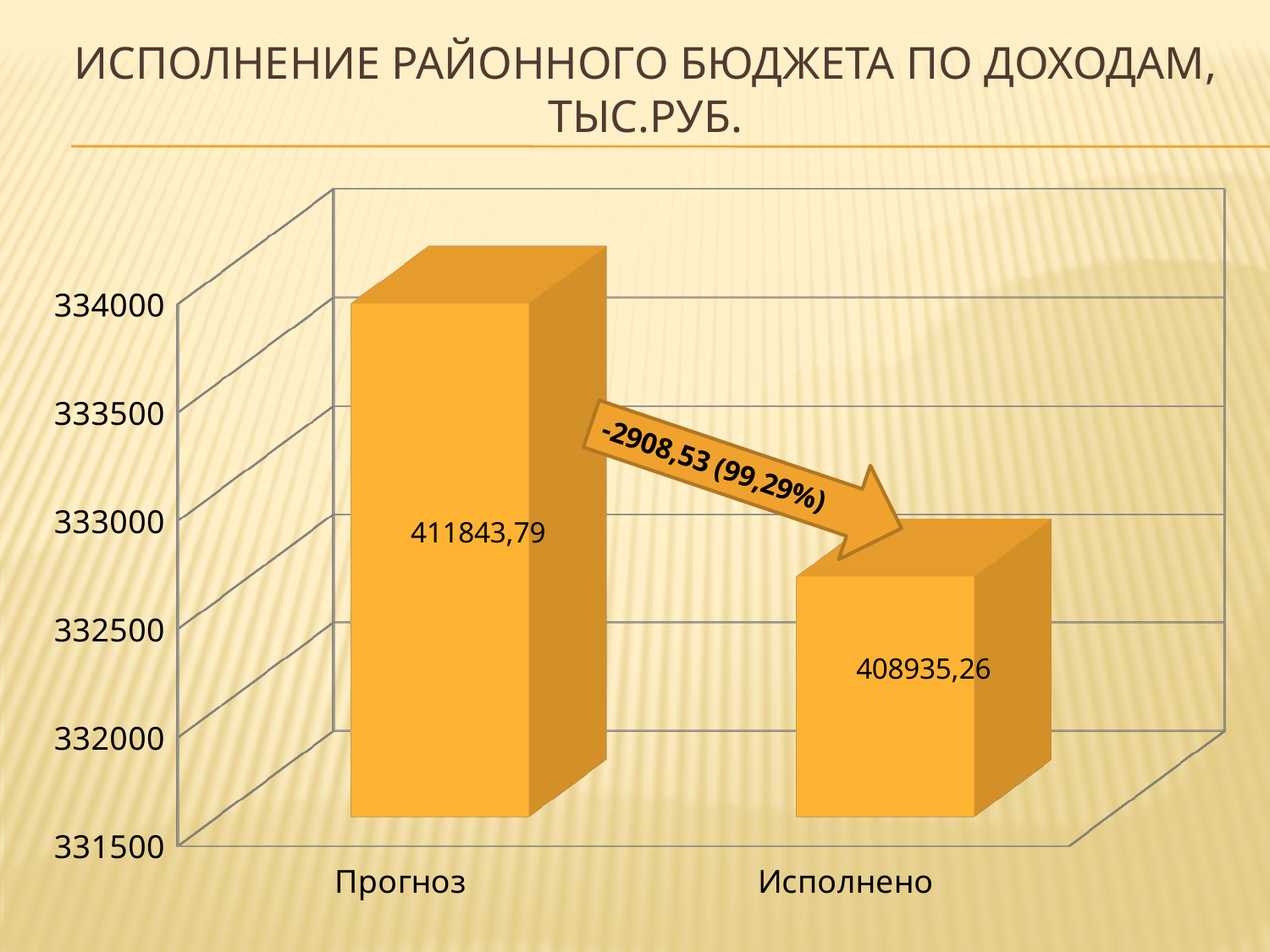
What percentage is shown in parentheses on the arrow? 99,29% Which category has the lowest value? Исполнено What text is written on the arrow between the two bars? -2908,53 (99,29%) How many categories are shown on the chart? 2 Which category has the highest value? Прогноз Which is larger, the value for Прогноз or the value for Исполнено? Прогноз Do the values rise or fall from Прогноз to Исполнено? Fall What is the value for Исполнено? 408935,26 What kind of chart is shown on the slide? Bar chart What is the difference between the values for Прогноз and Исполнено? 2908,53 What is the title of the chart? Исполнение районного бюджета по доходам, тыс.руб. What is the value for Прогноз? 411843,79